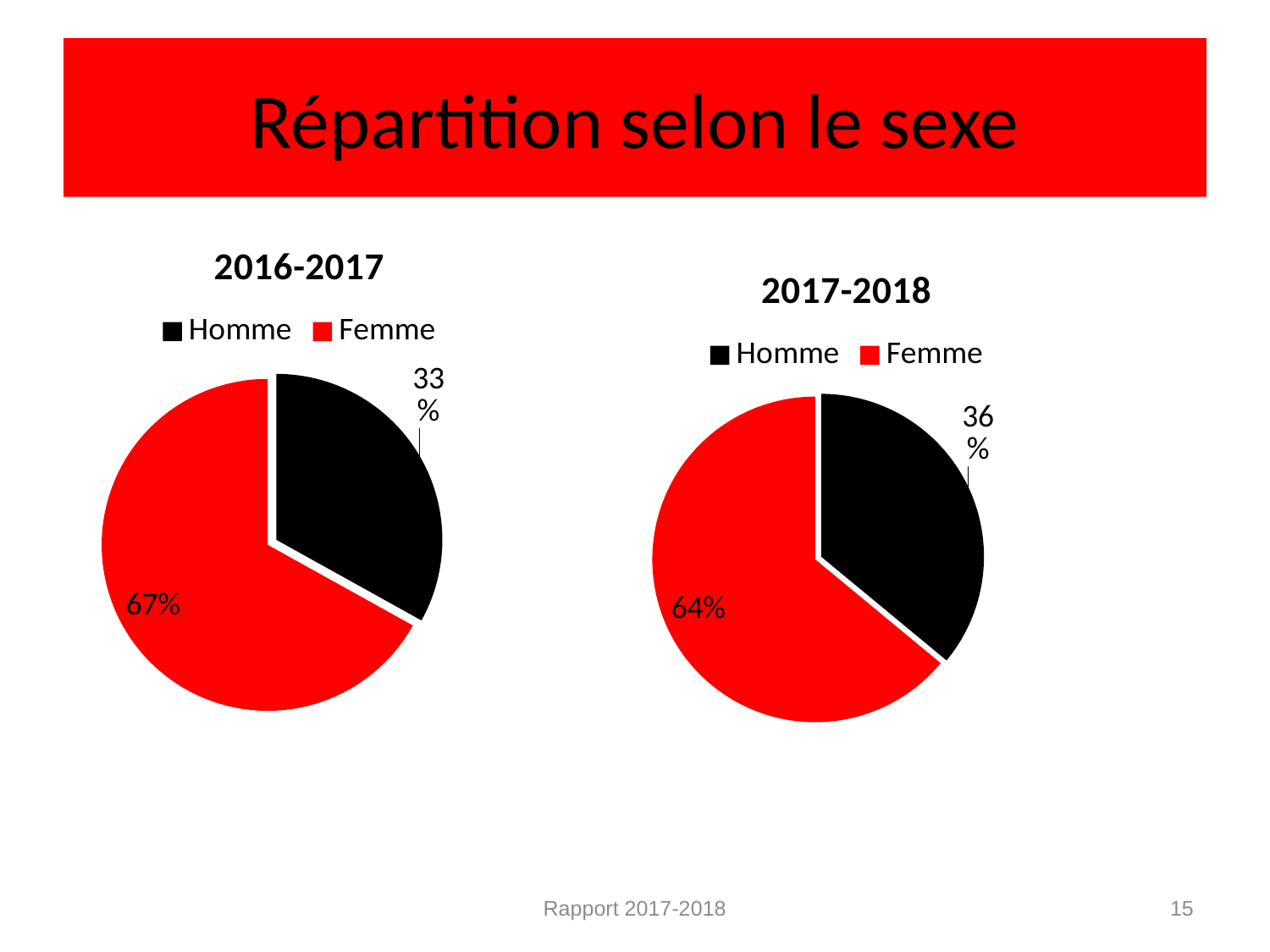
In the 2017-2018 chart, what colour is the Femme slice? Red What kind of chart is the 2017-2018 chart? Pie chart In the 2017-2018 chart, what share of the pie is Homme? 36% In the 2016-2017 chart, which category has the largest slice? Femme In the 2017-2018 chart, what is the difference between the Femme and Homme shares? 28% How many categories does the 2016-2017 chart show? 2 In the 2016-2017 chart, what is the difference between the Femme and Homme shares? 34% Is the Homme share larger in the 2016-2017 chart or the 2017-2018 chart? 2017-2018 In the 2017-2018 chart, which category has the smallest slice? Homme In the 2016-2017 chart, what share of the pie is Homme? 33% In the 2017-2018 chart, what share of the pie is Femme? 64% In the 2016-2017 chart, what share of the pie is Femme? 67%